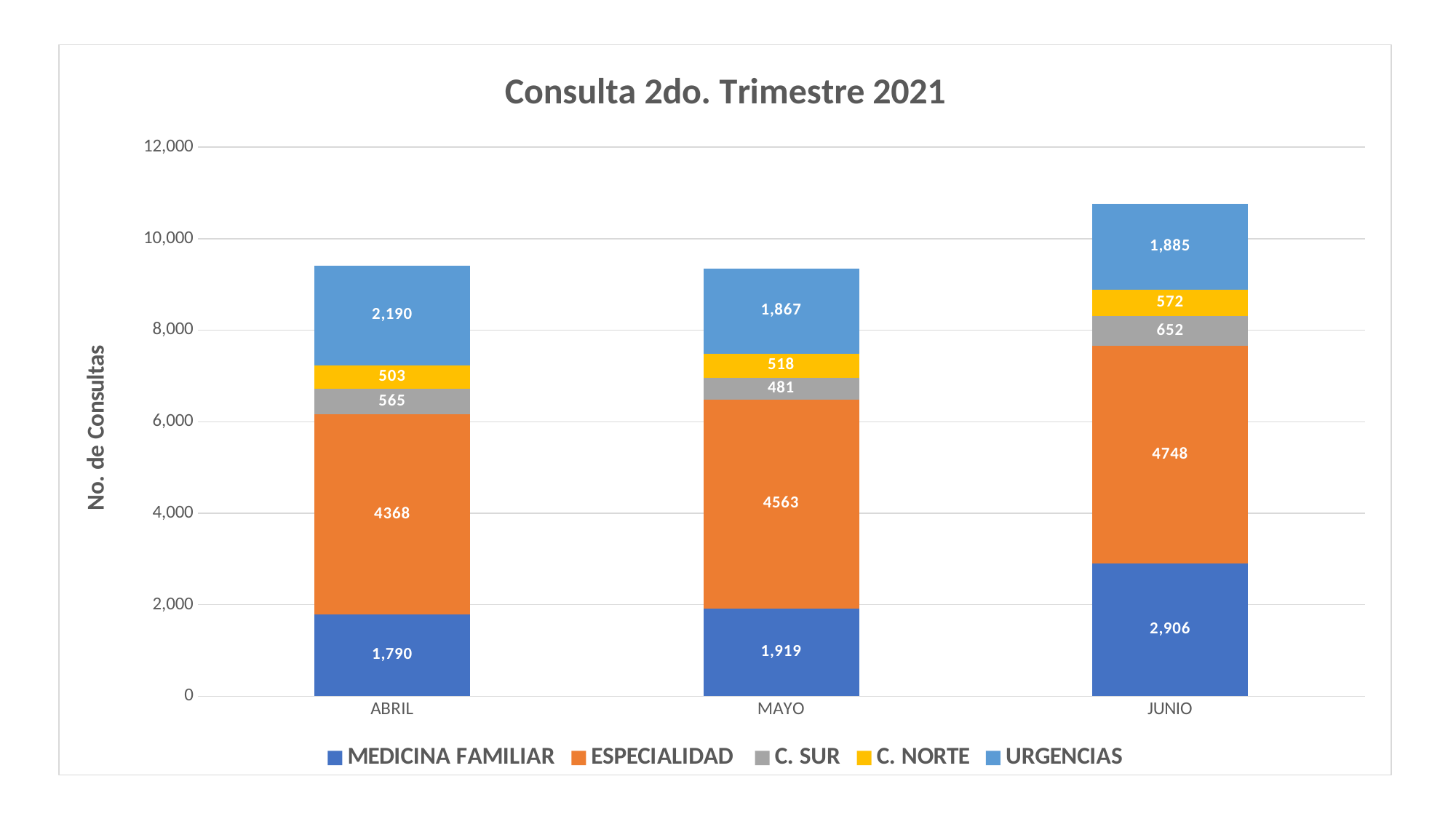
How many series does the legend list? 5 Which is larger, the URGENCIAS value for ABRIL or for MAYO? ABRIL What is the difference between the ESPECIALIDAD values for JUNIO and ABRIL? 380 In which month is the MEDICINA FAMILIAR value highest? JUNIO What is the value for C. SUR in JUNIO? 652 What is the value for ESPECIALIDAD in MAYO? 4563 How many months are shown on the x axis? 3 In which month is the C. SUR value lowest? MAYO What is the value for URGENCIAS in ABRIL? 2,190 What is the value for MEDICINA FAMILIAR in MAYO? 1,919 What is the title of the chart? Consulta 2do. Trimestre 2021 What is the total of the stacked bar for JUNIO? 10,763